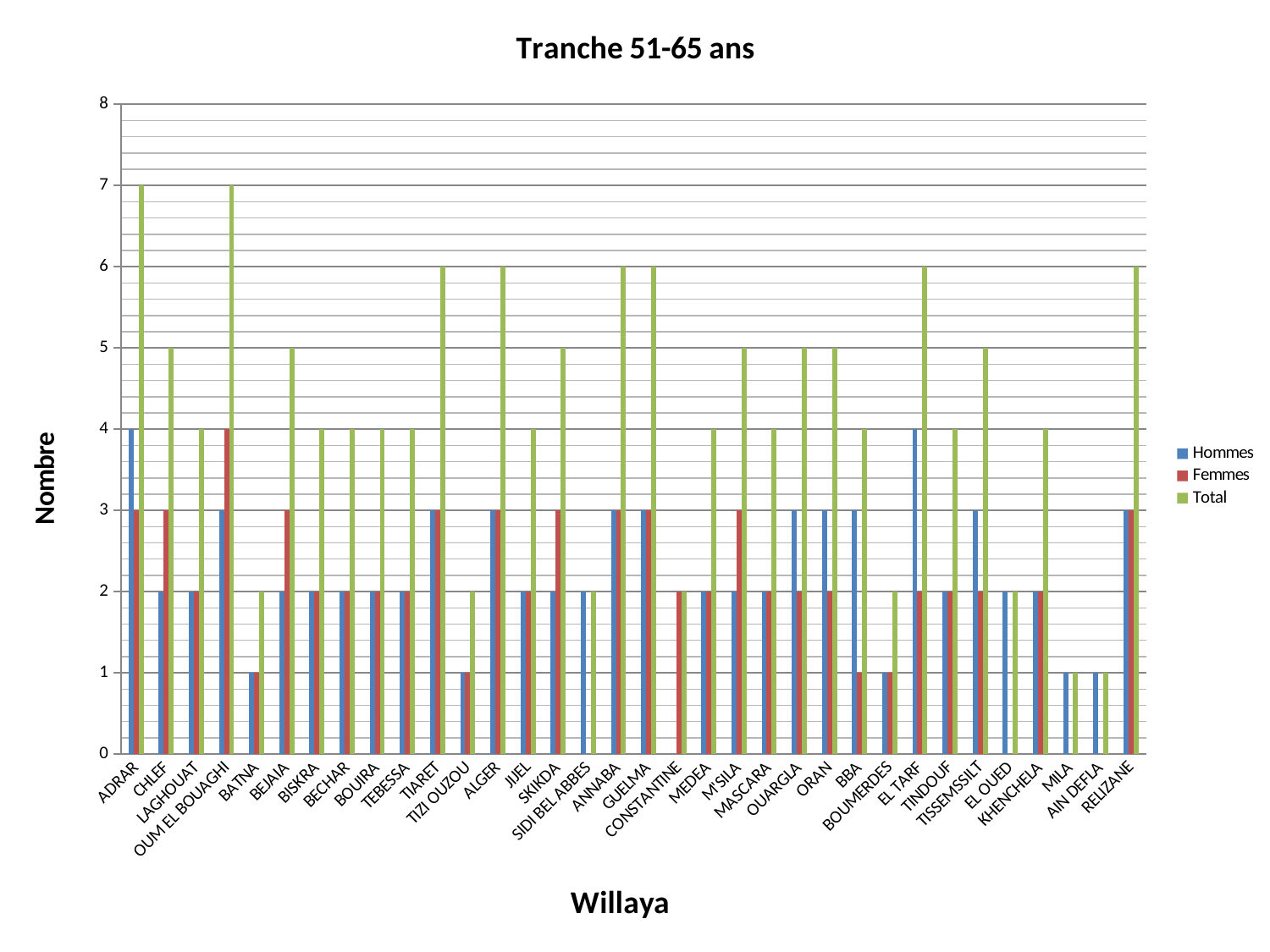
What is the Hommes value for EL TARF? 4 Which is larger, the Hommes value for ADRAR or the Hommes value for CHLEF? ADRAR How many series does the legend list? 3 What is the Total value for MILA? 1 What is the title of the chart? Tranche 51-65 ans What is the difference between the Total values for TIARET and BATNA? 4 What is the label of the x axis? Willaya What is the Total value for ADRAR? 7 What type of chart is shown on the slide? bar chart Which wilaya has the highest Femmes value? OUM EL BOUAGHI What is the Femmes value for OUM EL BOUAGHI? 4 Is the Total value for RELIZANE greater or less than 4? greater